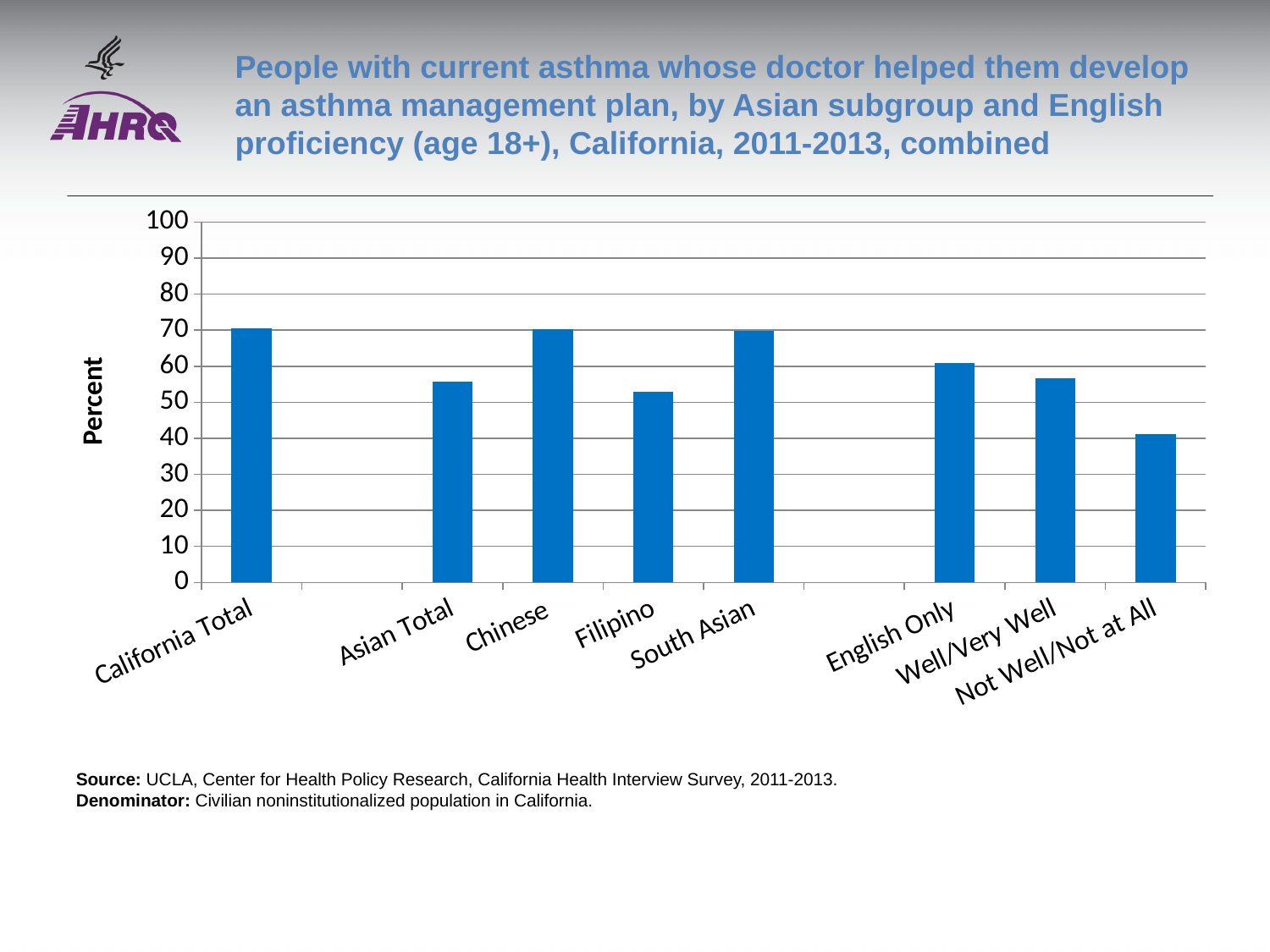
Is the value for Asian Total greater or less than 70? less How many categories (bars) are plotted in the chart? 8 Is the value for California Total greater or less than 60? greater Which is larger, the value for Chinese or the value for Filipino? Chinese Which is larger, the value for English Only or the value for Not Well/Not at All? English Only What kind of chart is shown on the slide? bar chart Is the value for Filipino greater or less than 60? less Which is larger, the value for South Asian or the value for Asian Total? South Asian What is the label on the vertical axis of the chart? Percent Which category has the lowest value in the chart? Not Well/Not at All